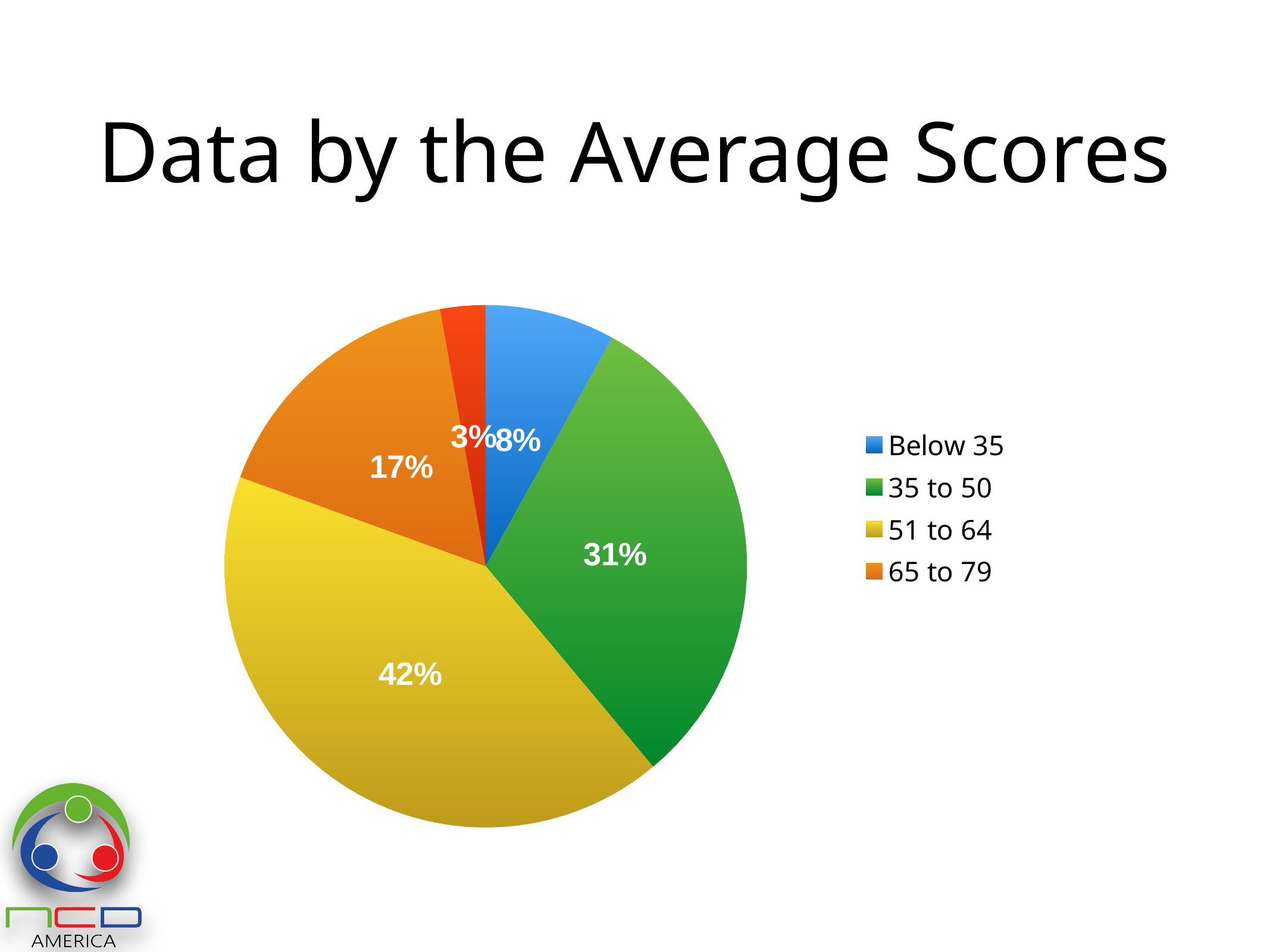
What kind of chart is shown on the slide? pie chart Which category has the largest slice of the pie? 51 to 64 What share of the pie does the "35 to 50" slice represent? 31% Which of the legend categories has the smallest slice of the pie? Below 35 How many entries does the legend list? 4 What share of the pie does the "51 to 64" slice represent? 42% Which slice is larger, "65 to 79" or "Below 35"? 65 to 79 What share of the pie does the "Below 35" slice represent? 8% What is the difference in percentage points between the "51 to 64" slice and the "35 to 50" slice? 11 What is the title of the slide containing the pie chart? Data by the Average Scores How many slices does the pie chart have? 5